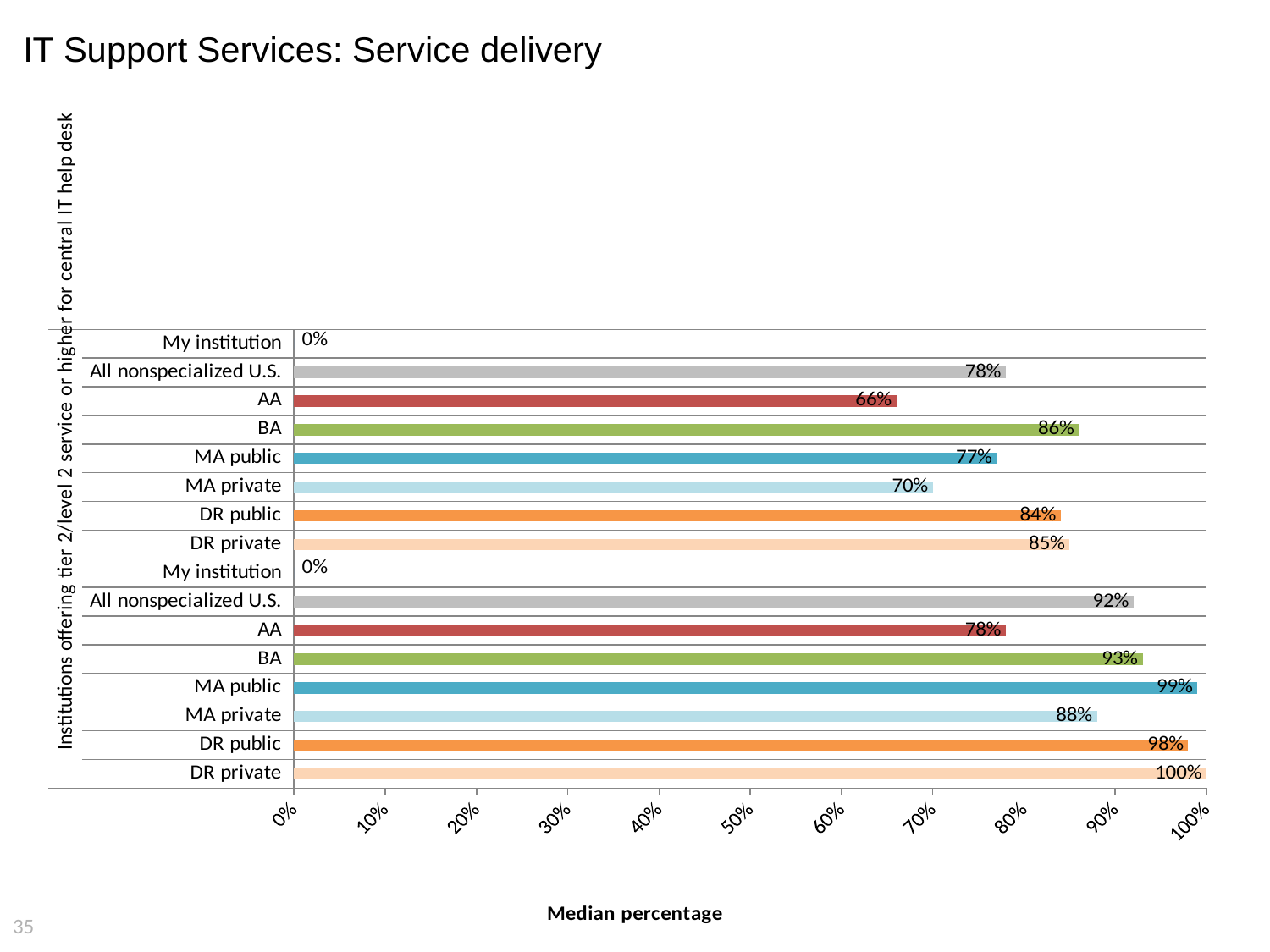
What is the value for AA in the upper group of bars? 66% Which is larger in the upper group: MA public or MA private? MA public What type of chart is shown on the slide? Bar chart What is the value for All nonspecialized U.S. in the lower group of bars? 92% What is the title of the horizontal axis? Median percentage What is the difference between DR public and DR private in the upper group of bars? 1% Excluding My institution, which category has the lowest value in the upper group of bars? AA What is the value for MA private in the lower group of bars? 88% How many bars (categories) are plotted on the chart in total? 16 What is the value for BA in the upper group of bars? 86% What is the difference between MA public in the lower group and MA public in the upper group? 22% Which category has the highest value in the lower group of bars? DR private